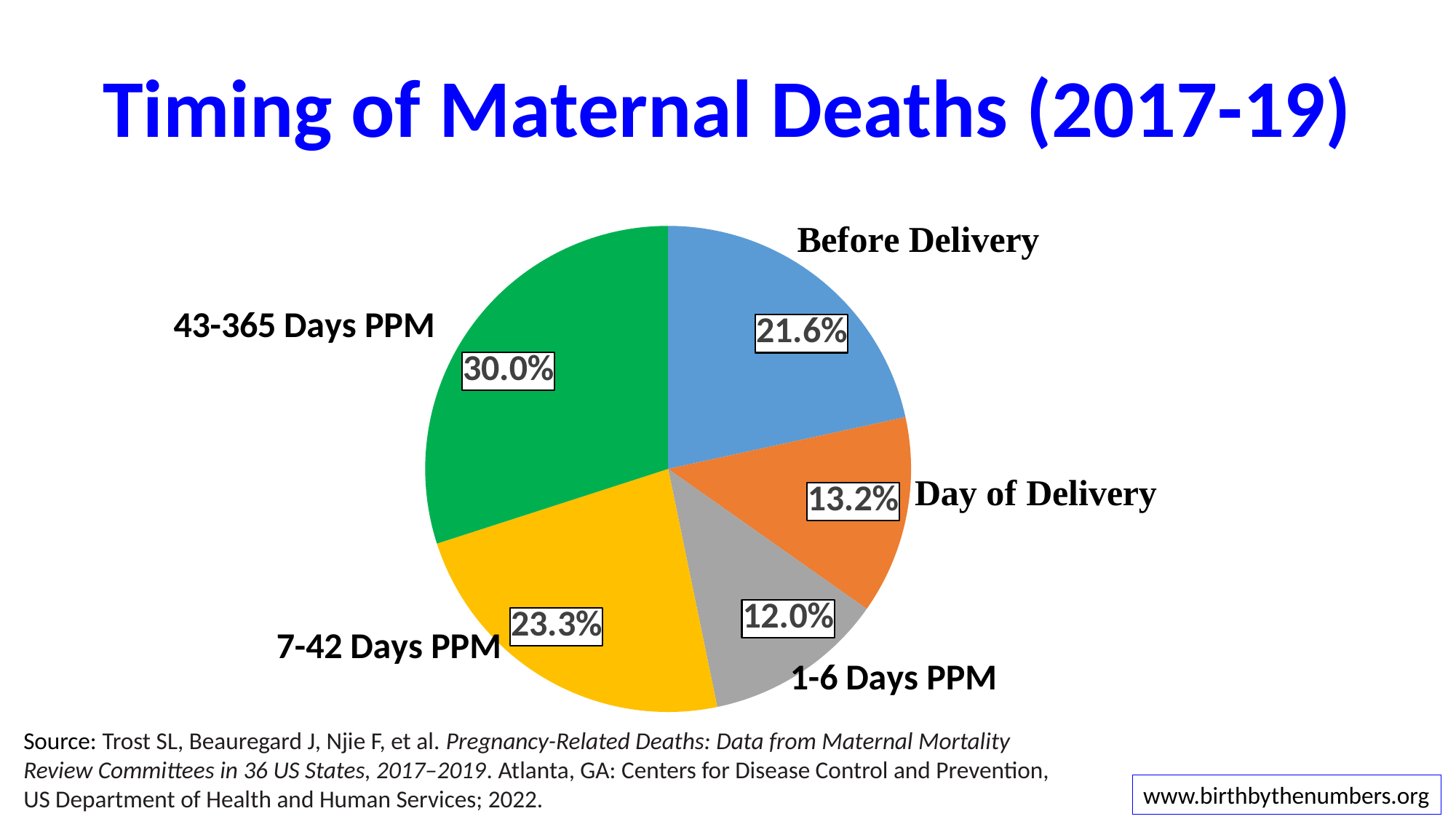
What percentage of maternal deaths occurred on the day of delivery? 13.2% What percentage of maternal deaths occurred 43-365 days PPM? 30.0% Which timing category has the largest share of maternal deaths? 43-365 Days PPM What kind of chart is shown on the slide? pie chart What is the title of the slide? Timing of Maternal Deaths (2017-19) Which timing category has the smallest share of maternal deaths? 1-6 Days PPM Which is larger: the share for Day of Delivery or the share for 1-6 Days PPM? Day of Delivery How many slices does the pie chart have? 5 What percentage of maternal deaths occurred 1-6 days PPM? 12.0% What is the difference in percentage points between the 43-365 Days PPM slice and the Before Delivery slice? 8.4 What percentage of maternal deaths occurred before delivery? 21.6% What percentage of maternal deaths occurred 7-42 days PPM? 23.3%